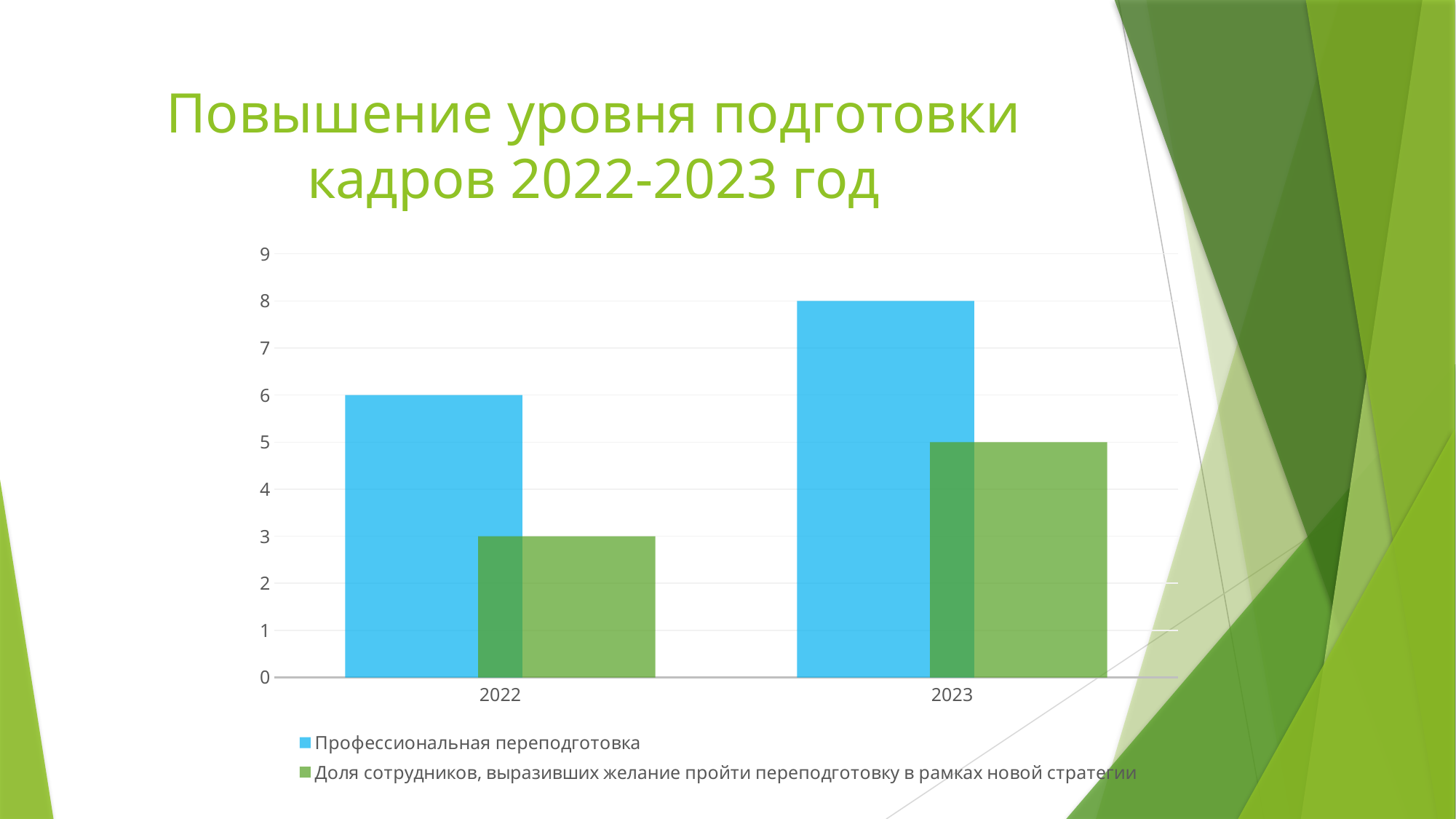
What is the value of Профессиональная переподготовка for 2023? 8 How many series does the legend list? 2 How many years are shown on the x axis? 2 Do the values of Профессиональная переподготовка rise or fall from 2022 to 2023? Rise Which is larger in 2023: Профессиональная переподготовка or Доля сотрудников, выразивших желание пройти переподготовку в рамках новой стратегии? Профессиональная переподготовка What kind of chart is shown on the slide? Bar chart What is the value of Доля сотрудников, выразивших желание пройти переподготовку в рамках новой стратегии for 2022? 3 What is the difference between the Профессиональная переподготовка values for 2023 and 2022? 2 In which year is Доля сотрудников, выразивших желание пройти переподготовку в рамках новой стратегии lowest? 2022 In which year is Профессиональная переподготовка highest? 2023 What is the value of Доля сотрудников, выразивших желание пройти переподготовку в рамках новой стратегии for 2023? 5 What is the value of Профессиональная переподготовка for 2022? 6